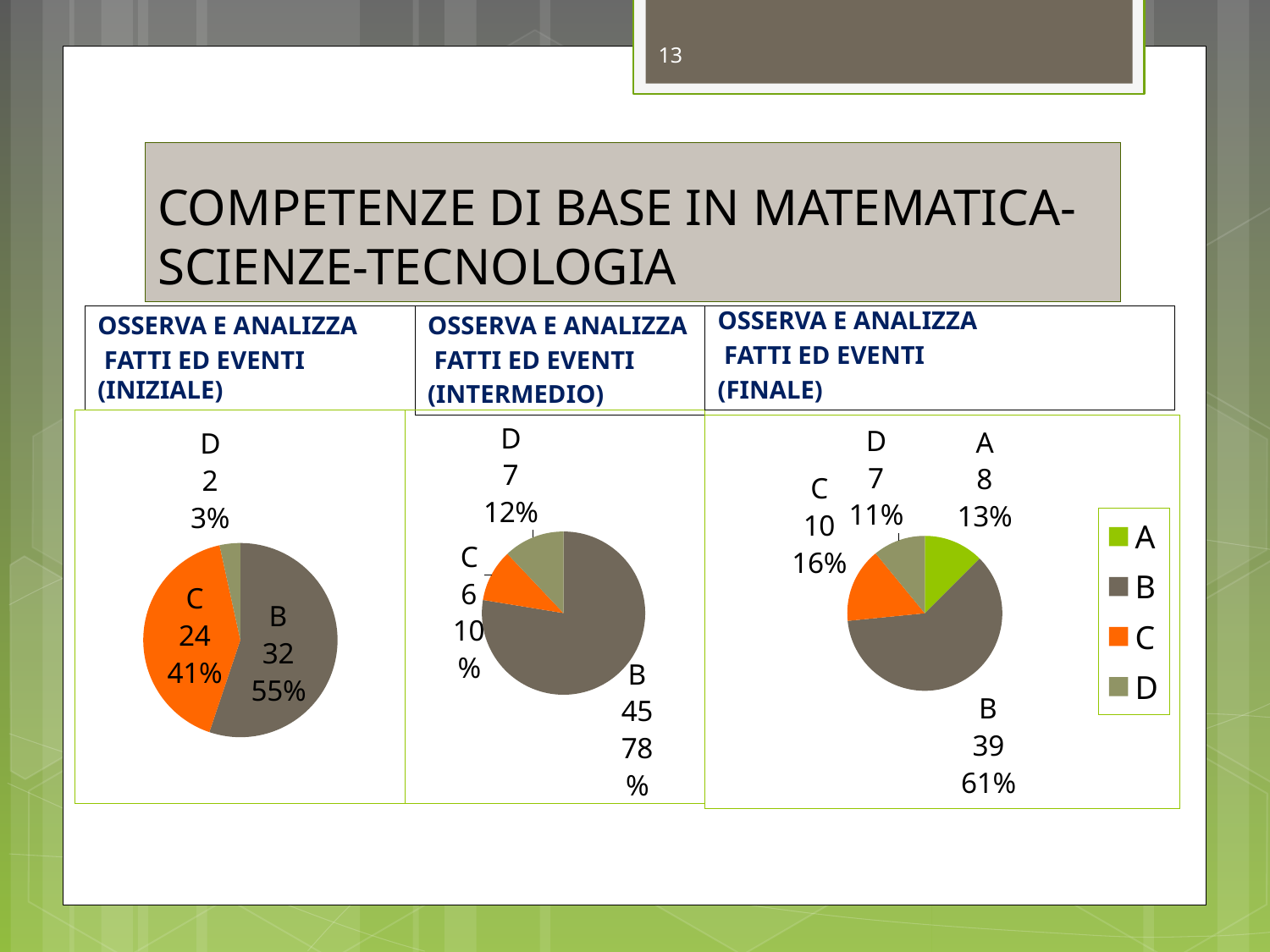
In the INTERMEDIO pie chart, which is larger, category C or category D? D In the FINALE pie chart, what is the value for category A? 8 How many categories are shown in the FINALE pie chart? 4 In the FINALE pie chart, which category is the largest? B How many entries does the legend on the right of the slide list? 4 In the INTERMEDIO pie chart, what is the value for category B? 45 In the INIZIALE pie chart, what is the value for category B? 32 In the FINALE pie chart, what is the difference between the values for category B and category C? 29 In the INIZIALE pie chart, which category is the smallest? D What kind of chart is used for the INIZIALE data? Pie chart In the INIZIALE pie chart, what share of the pie does category C have? 41% In the INTERMEDIO pie chart, what share of the pie does category D have? 12%